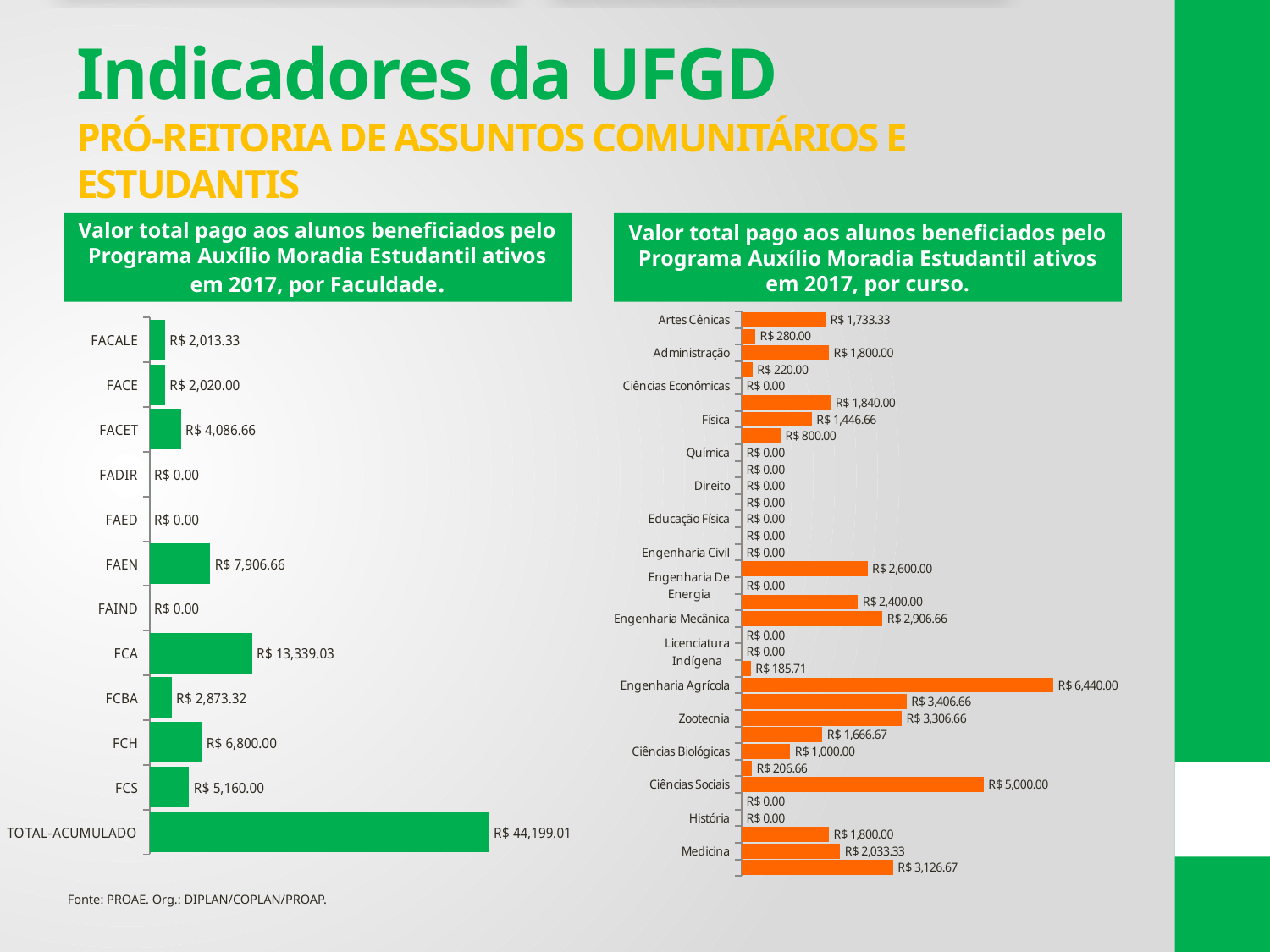
In the right chart (por curso), what is the value shown for Ciências Sociais? R$ 5,000.00 In the left chart (por Faculdade), how many faculties show a value of R$ 0.00? 3 What colour are the bars in the right chart (por curso)? Orange In the right chart (por curso), what is the value shown for Engenharia Agrícola? R$ 6,440.00 In the left chart (por Faculdade), what is the difference between the values for FAEN and FCH? R$ 1,106.66 What kind of chart is the left chart (por Faculdade)? Bar chart In the left chart (por Faculdade), how many bars are plotted, including TOTAL-ACUMULADO? 12 In the left chart (por Faculdade), which is larger, the value for FACET or the value for FCBA? FACET In the left chart (por Faculdade), which faculty (excluding the accumulated total) has the highest value? FCA In the left chart (por Faculdade), what is the value for FAEN? R$ 7,906.66 In the left chart (por Faculdade), what is the TOTAL-ACUMULADO value? R$ 44,199.01 In the left chart (por Faculdade), what is the value for FCA? R$ 13,339.03